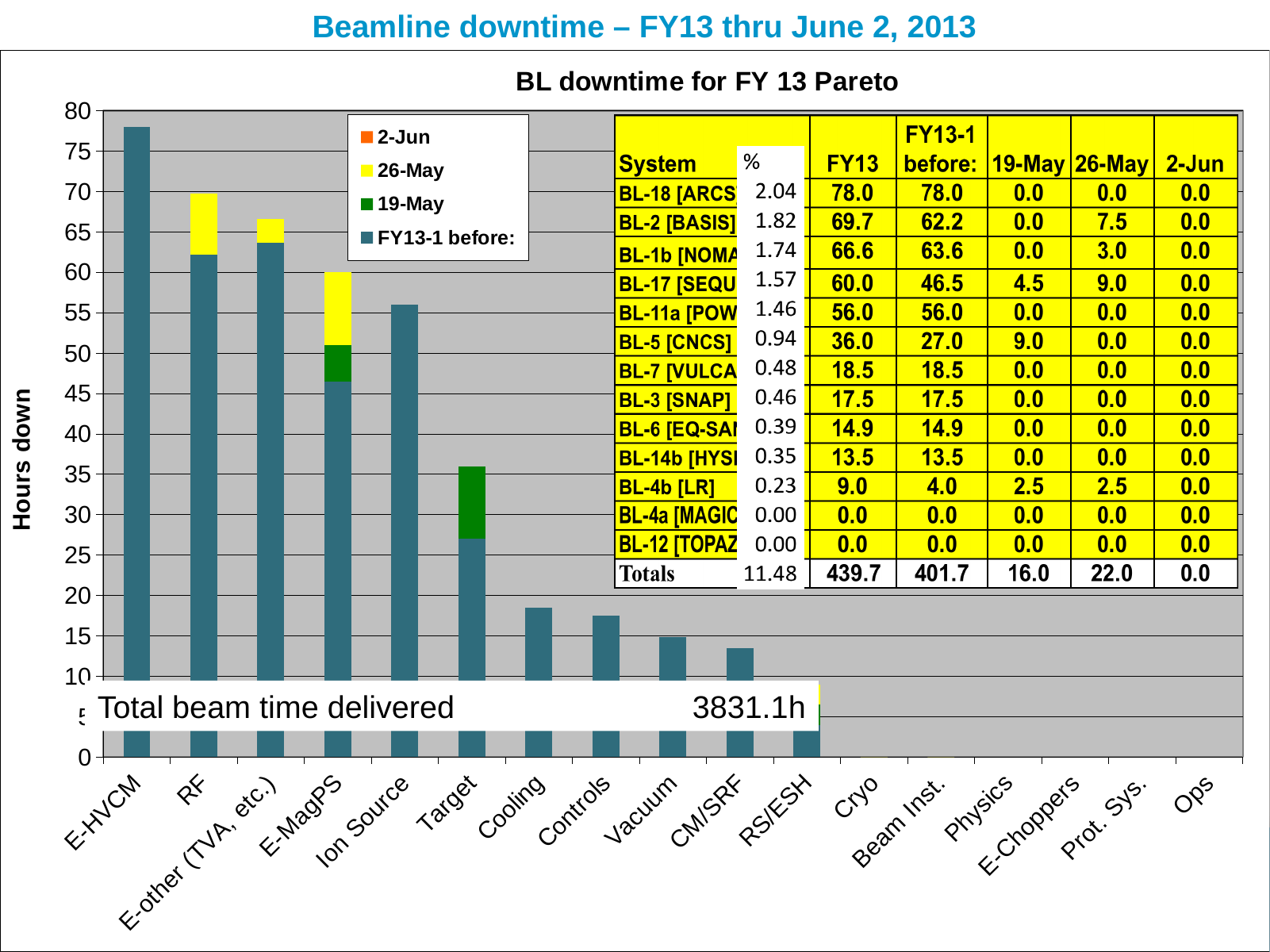
Is the total value for Cooling greater or less than 20? less How many categories are shown on the x axis of the chart? 17 Is the total value for Ion Source greater or less than 60? less Which category has the highest total hours down in the BL downtime chart? E-HVCM Do the bar totals generally rise or fall from left to right along the x axis? Fall How many series does the chart legend list? 4 What kind of chart is shown on the slide? Stacked bar chart What is the label on the vertical axis of the chart? Hours down Which has a larger total, Ion Source or Target? Ion Source Is the total value for E-HVCM greater or less than 75? greater